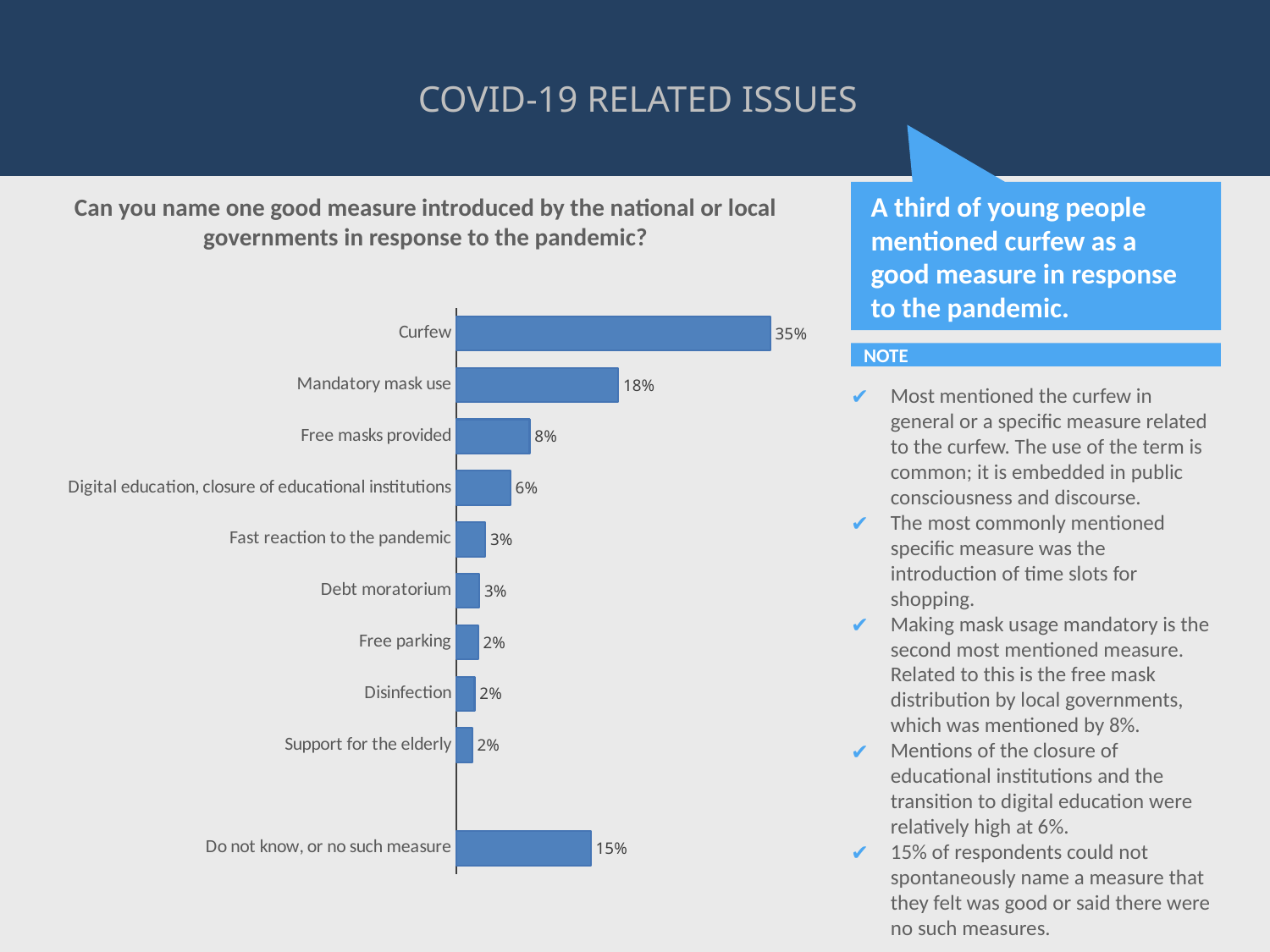
What question is the chart titled with? Can you name one good measure introduced by the national or local governments in response to the pandemic? Which measure has the highest percentage? Curfew Which is larger, the value for Free masks provided or the value for Debt moratorium? Free masks provided What kind of chart is shown on the slide? Bar chart What is the difference in percentage points between Curfew and Mandatory mask use? 17 Which is larger, the value for Mandatory mask use or the value for Do not know, or no such measure? Mandatory mask use What percentage of respondents named curfew as a good measure? 35% What is the difference in percentage points between Free masks provided and Fast reaction to the pandemic? 5 How many categories are shown in the chart? 10 What is the value for Digital education, closure of educational institutions? 6% What percentage of respondents answered 'Do not know, or no such measure'? 15% What is the value for Mandatory mask use? 18%